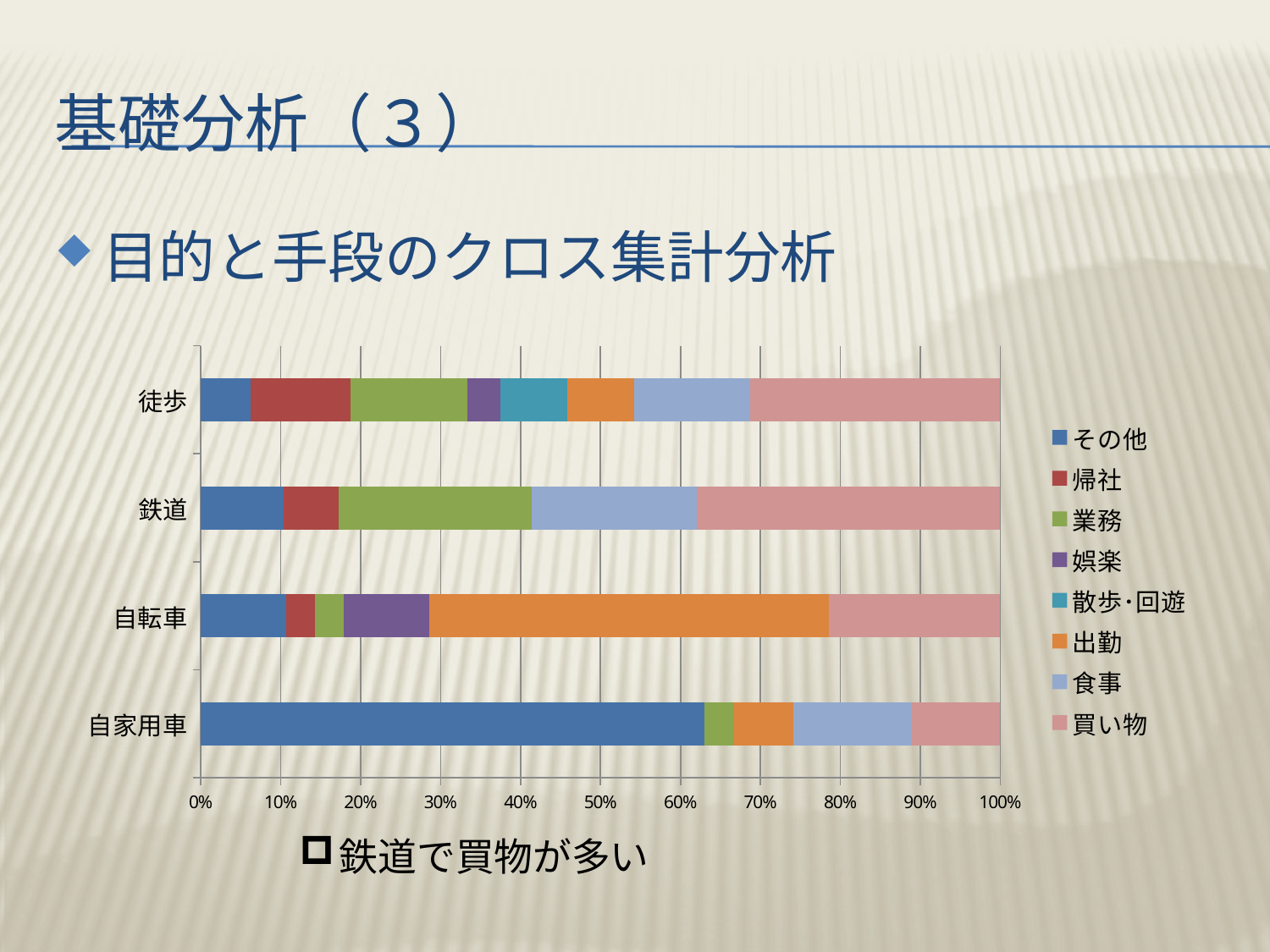
How many series does the legend list? 8 What kind of chart is shown on the slide? Stacked bar chart What is the last entry listed in the legend? 買い物 Which transport mode has the largest その他 share? 自家用車 How many transport modes (categories) are plotted on the vertical axis? 4 Which transport mode has the largest 出勤 share? 自転車 Is the 出勤 share for 自転車 greater or less than 40%? greater Is the 買い物 share for 鉄道 greater or less than 30%? greater Which has the larger 買い物 share, 鉄道 or 自家用車? 鉄道 Is the その他 share for 自家用車 greater or less than 60%? greater Which has the larger 業務 share, 鉄道 or 自転車? 鉄道